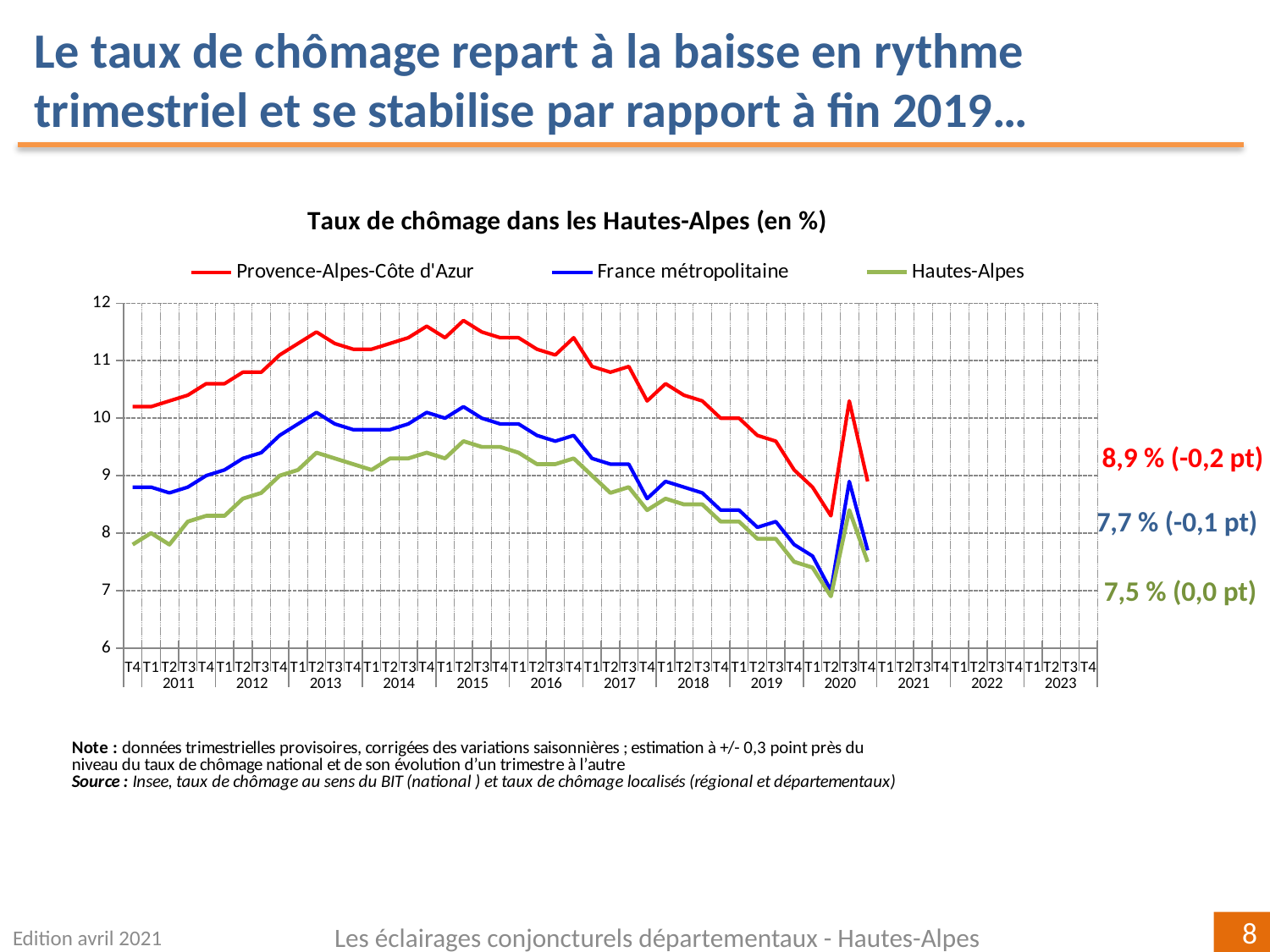
What is the latest unemployment rate shown for Provence-Alpes-Côte d'Azur? 8,9 % Is the value for Provence-Alpes-Côte d'Azur in T1 2020 greater or less than 9? less Which series has the highest values across the whole period? Provence-Alpes-Côte d'Azur What is the latest unemployment rate shown for Hautes-Alpes? 7,5 % Which series has the lowest values across the whole period? Hautes-Alpes What is the title of the chart? Taux de chômage dans les Hautes-Alpes (en %) Does the Provence-Alpes-Côte d'Azur line rise or fall between 2015 and 2019? fall What quarterly change is indicated next to the latest Provence-Alpes-Côte d'Azur value? -0,2 pt What is the difference between the latest values for Provence-Alpes-Côte d'Azur and Hautes-Alpes? 1,4 points What is the latest unemployment rate shown for France métropolitaine? 7,7 % What kind of chart is shown on the slide? line chart How many series does the legend list? 3